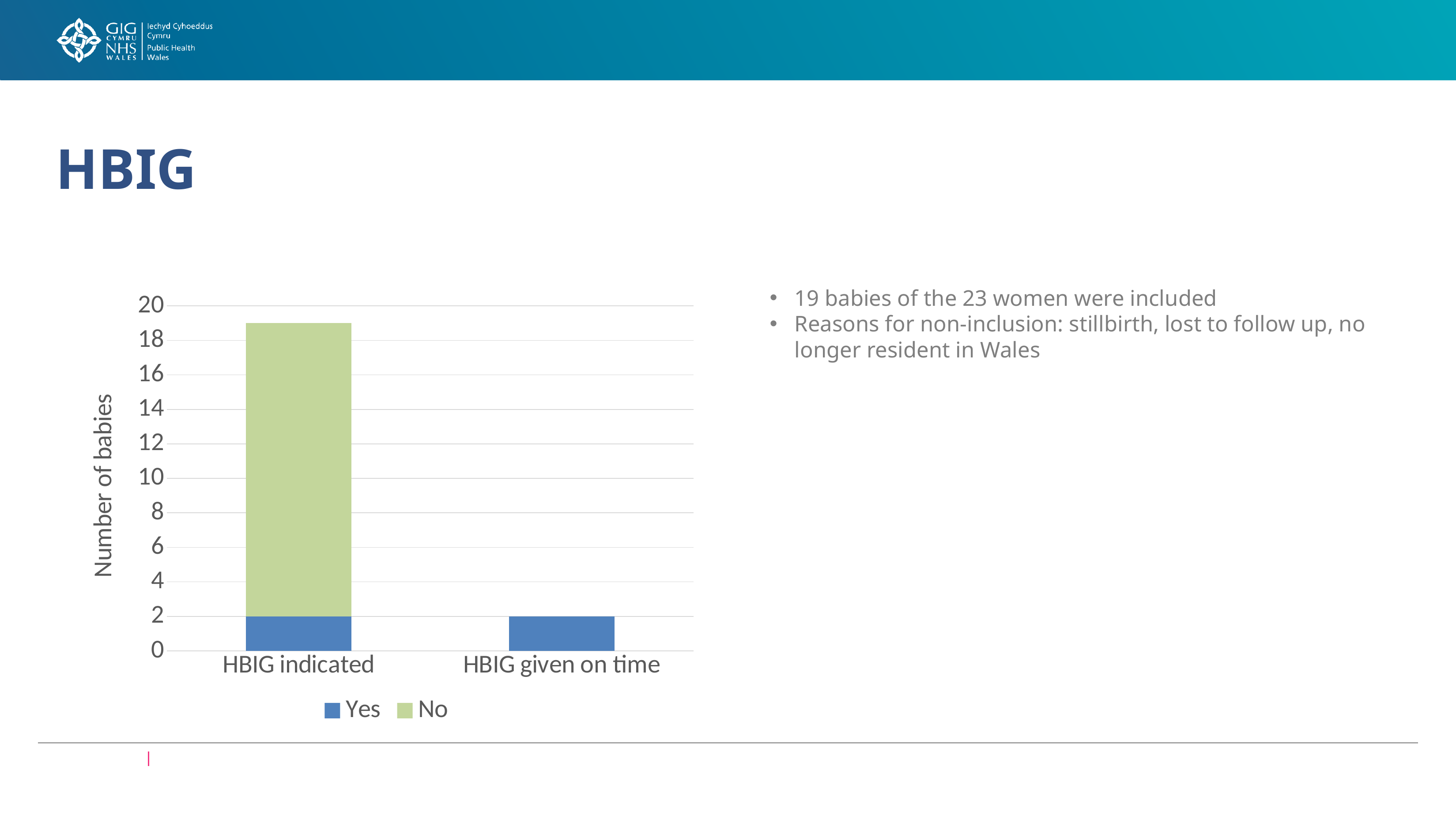
What is the title of the vertical axis of the chart? Number of babies Is the No segment for HBIG indicated greater or less than 10? greater What kind of chart is shown on the slide? bar chart Which category has the shorter stacked bar overall? HBIG given on time How many categories are shown on the x axis of the chart? 2 Within the HBIG indicated bar, which series is larger, Yes or No? No Which category has the taller stacked bar overall? HBIG indicated Which series is shown in green in the chart's legend? No What is the value of the Yes series for HBIG indicated? 2 What is the value of the Yes series for HBIG given on time? 2 How many series does the chart's legend list? 2 Is the total stacked bar for HBIG indicated greater or less than 18? greater